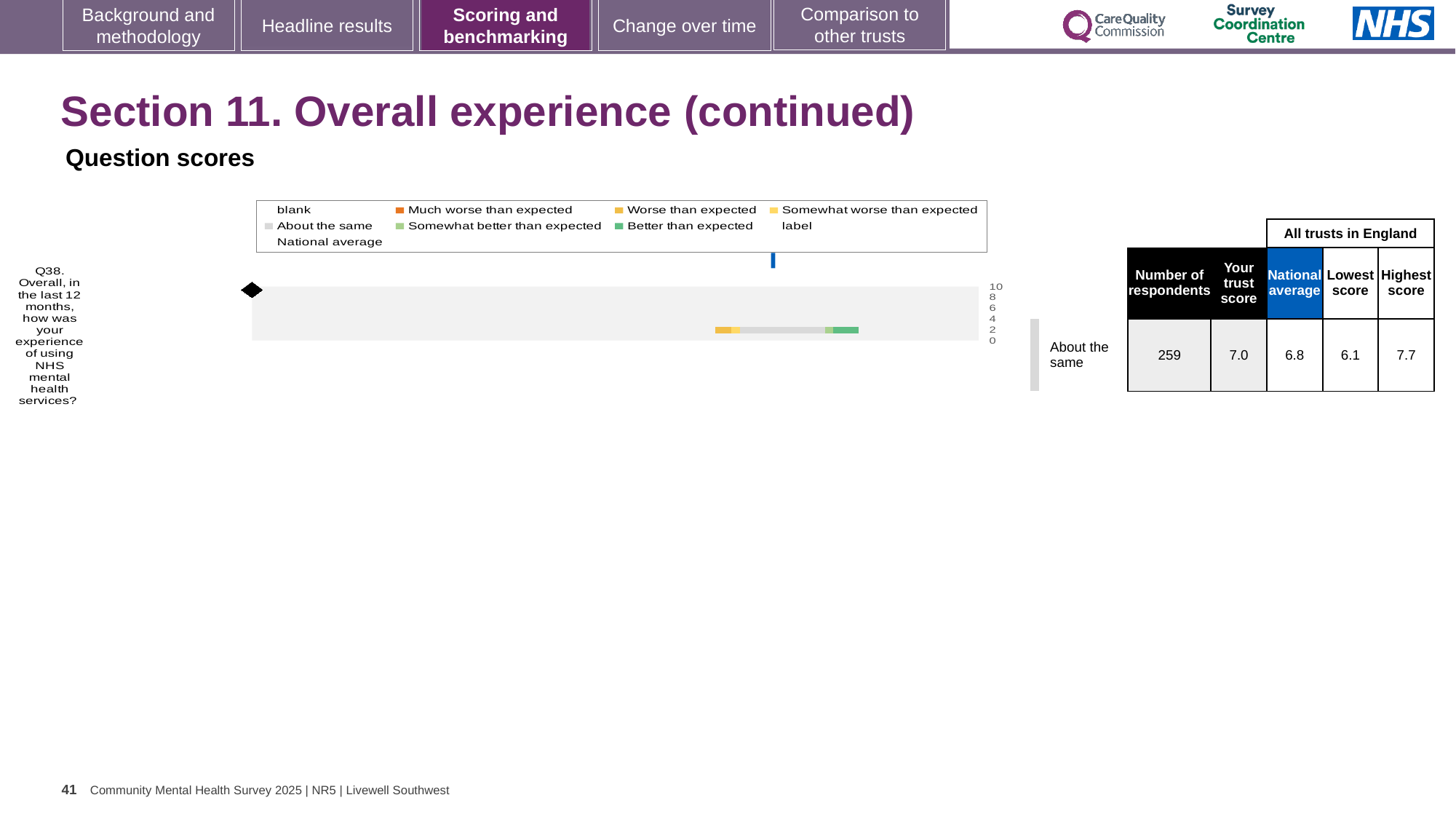
What is the national average score for Q38? 6.8 Which benchmarking category is the trust's Q38 score placed in? About the same How many respondents answered Q38? 259 Is the trust's score for Q38 greater or less than 6? greater What is the highest score among all trusts in England for Q38? 7.7 What is the trust's score for Q38, 'Overall, in the last 12 months, how was your experience of using NHS mental health services?' 7.0 How many questions (categories) are plotted in the chart? 1 Which is larger for Q38: the trust's score or the national average? the trust's score What is the difference between the trust's score and the national average for Q38? 0.2 What kind of chart is shown on the slide for Q38? bar chart What is the lowest score among all trusts in England for Q38? 6.1 What is the difference between the highest and lowest trust scores for Q38? 1.6